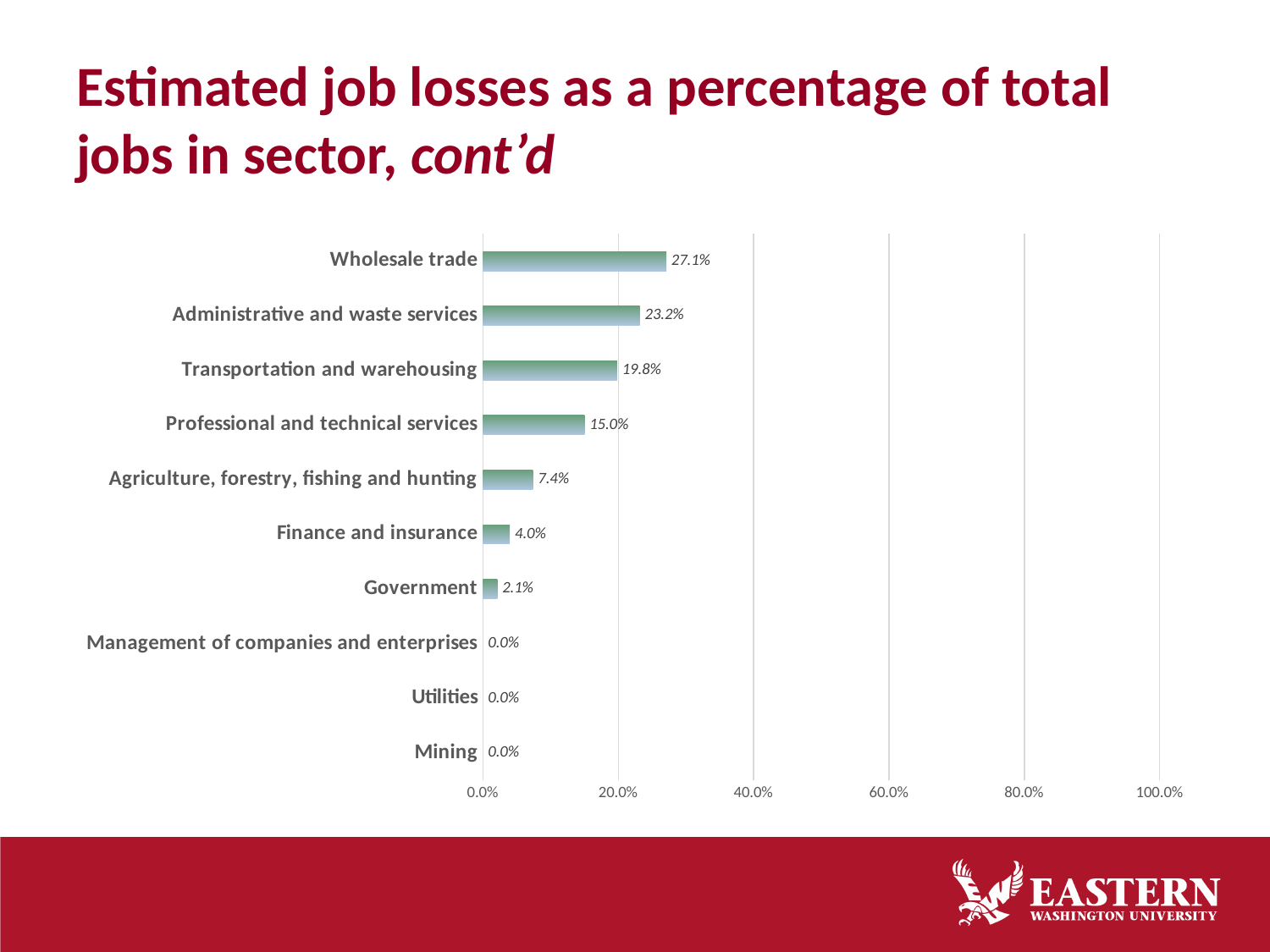
What is the difference between the values for Wholesale trade and Administrative and waste services? 3.9% What is the value shown for Finance and insurance? 4.0% Which sector has the highest estimated job loss percentage? Wholesale trade What is the value shown for Transportation and warehousing? 19.8% Which is larger, the value for Administrative and waste services or the value for Transportation and warehousing? Administrative and waste services What kind of chart is shown on the slide? Bar chart How many sectors are shown on the chart? 10 What is the estimated job loss percentage for Wholesale trade? 27.1% What is the value shown for Government? 2.1% How many sectors show a value of 0.0%? 3 Is the value for Wholesale trade greater or less than 20.0%? greater What is the difference between the values for Professional and technical services and Agriculture, forestry, fishing and hunting? 7.6%